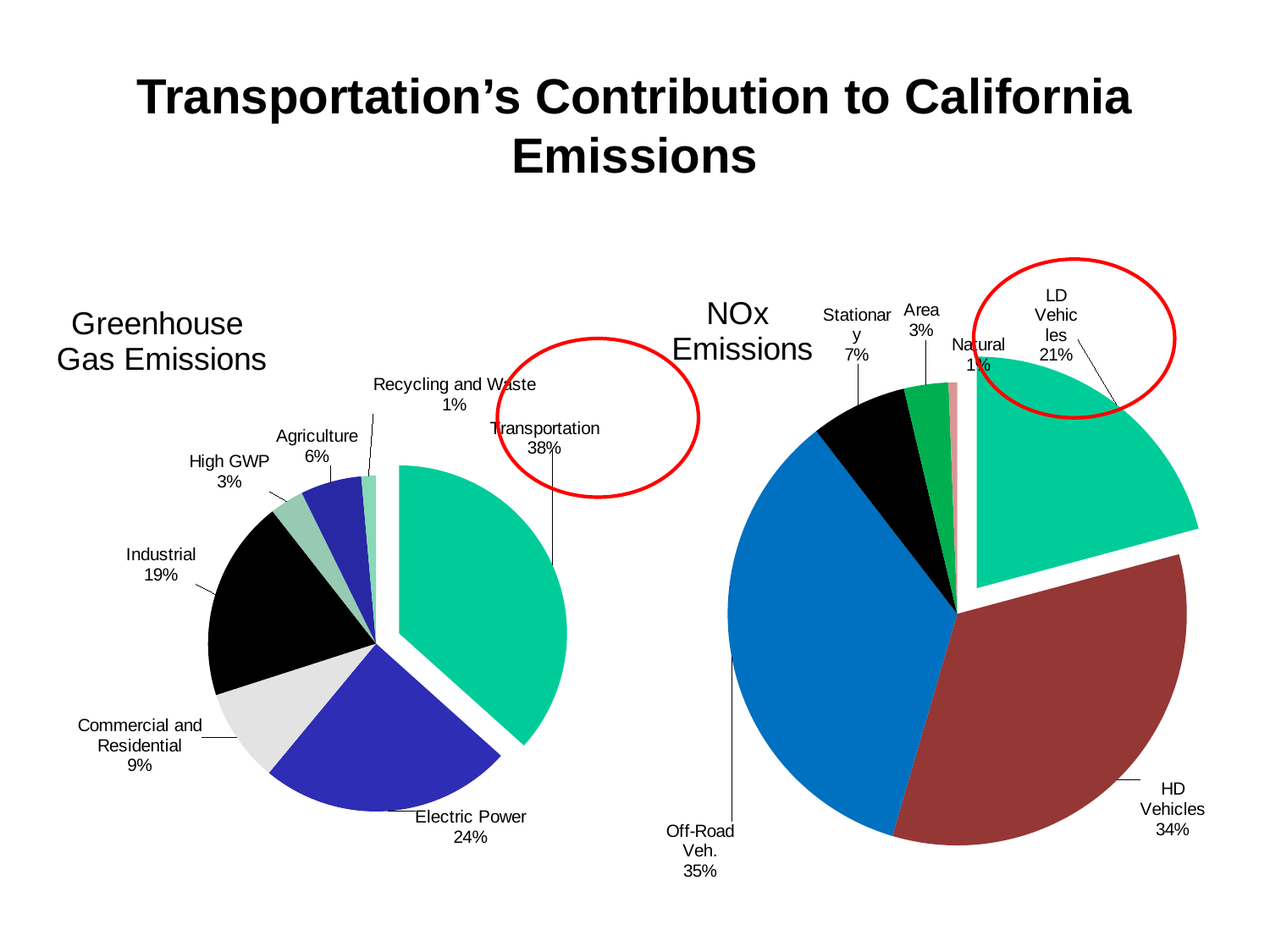
In the NOx Emissions chart, which category has the smallest share? Natural In the NOx Emissions chart, what share do HD Vehicles account for? 34% In the Greenhouse Gas Emissions chart, which category has the largest share? Transportation In the Greenhouse Gas Emissions chart, what is the difference between Industrial and Commercial and Residential? 10% In the Greenhouse Gas Emissions chart, how many categories are shown? 7 In the NOx Emissions chart, how many categories are shown? 6 In the Greenhouse Gas Emissions chart, which category has the smallest share? Recycling and Waste What type of chart is used for the Greenhouse Gas Emissions data? Pie chart In the NOx Emissions chart, which is larger, LD Vehicles or HD Vehicles? HD Vehicles In the NOx Emissions chart, what is the value for Stationary? 7% In the Greenhouse Gas Emissions chart, what is the value for Electric Power? 24% In the Greenhouse Gas Emissions chart, what share does Transportation account for? 38%